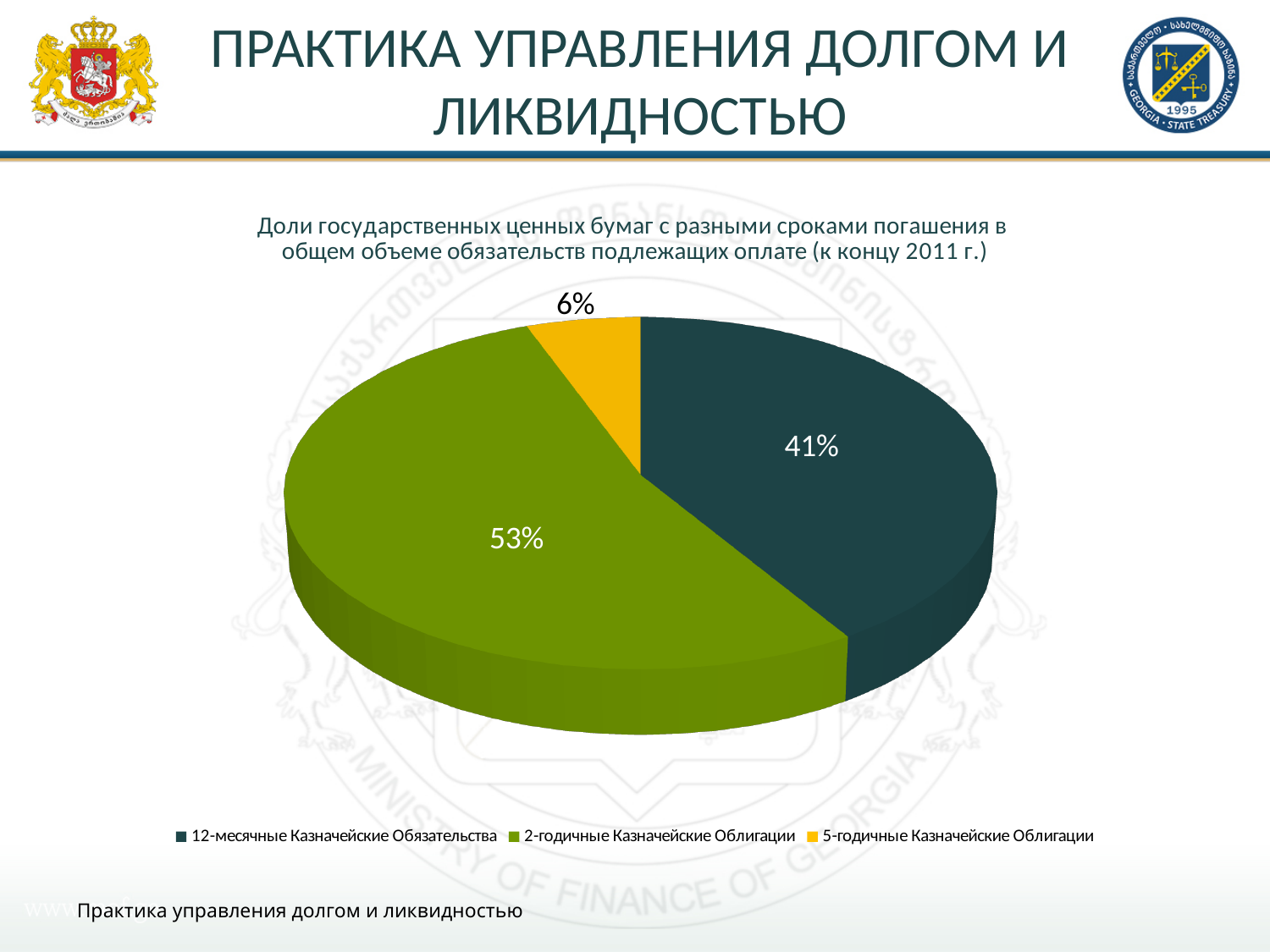
What share of the pie is labelled for 5-годичные Казначейские Облигации? 6% What year does the chart title say the data refers to? 2011 Which is larger: the slice for 12-месячные Казначейские Обязательства or the slice for 5-годичные Казначейские Облигации? 12-месячные Казначейские Обязательства What share of the pie is labelled for 2-годичные Казначейские Облигации? 53% What colour is the slice for 5-годичные Казначейские Облигации? yellow Which category has the smallest slice of the pie? 5-годичные Казначейские Облигации What is the difference in percentage points between the 2-годичные Казначейские Облигации slice and the 12-месячные Казначейские Обязательства slice? 12 How many entries does the legend list? 3 What kind of chart is shown on the slide? pie chart What share of the pie is labelled for 12-месячные Казначейские Обязательства? 41% How many slices does the pie chart have? 3 Which category has the largest slice of the pie? 2-годичные Казначейские Облигации